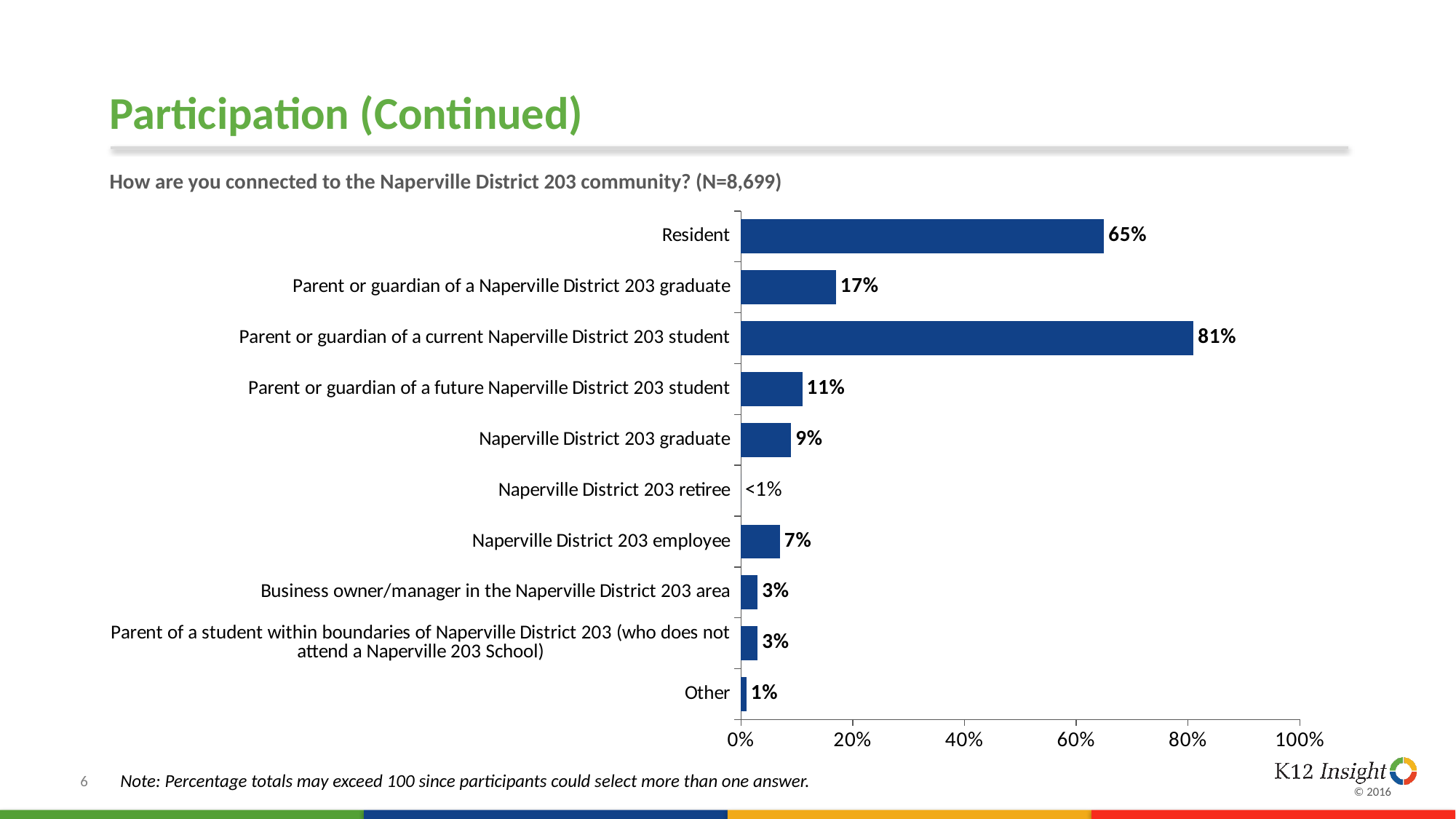
How many categories are shown in the chart? 10 What percentage of respondents are a parent or guardian of a current Naperville District 203 student? 81% What percentage of respondents are a Naperville District 203 employee? 7% What value is shown for Naperville District 203 retiree? <1% What is the difference in percentage points between Resident and Parent or guardian of a Naperville District 203 graduate? 48 What kind of chart is shown on the slide? Bar chart Which is larger: the value for Parent or guardian of a future Naperville District 203 student or the value for Naperville District 203 graduate? Parent or guardian of a future Naperville District 203 student What percentage of respondents are a Resident? 65% Which category has the highest percentage? Parent or guardian of a current Naperville District 203 student Which category has the lowest percentage? Naperville District 203 retiree Is the value for Resident greater or less than 60%? greater What is the sample size (N) stated in the chart's question text? 8,699